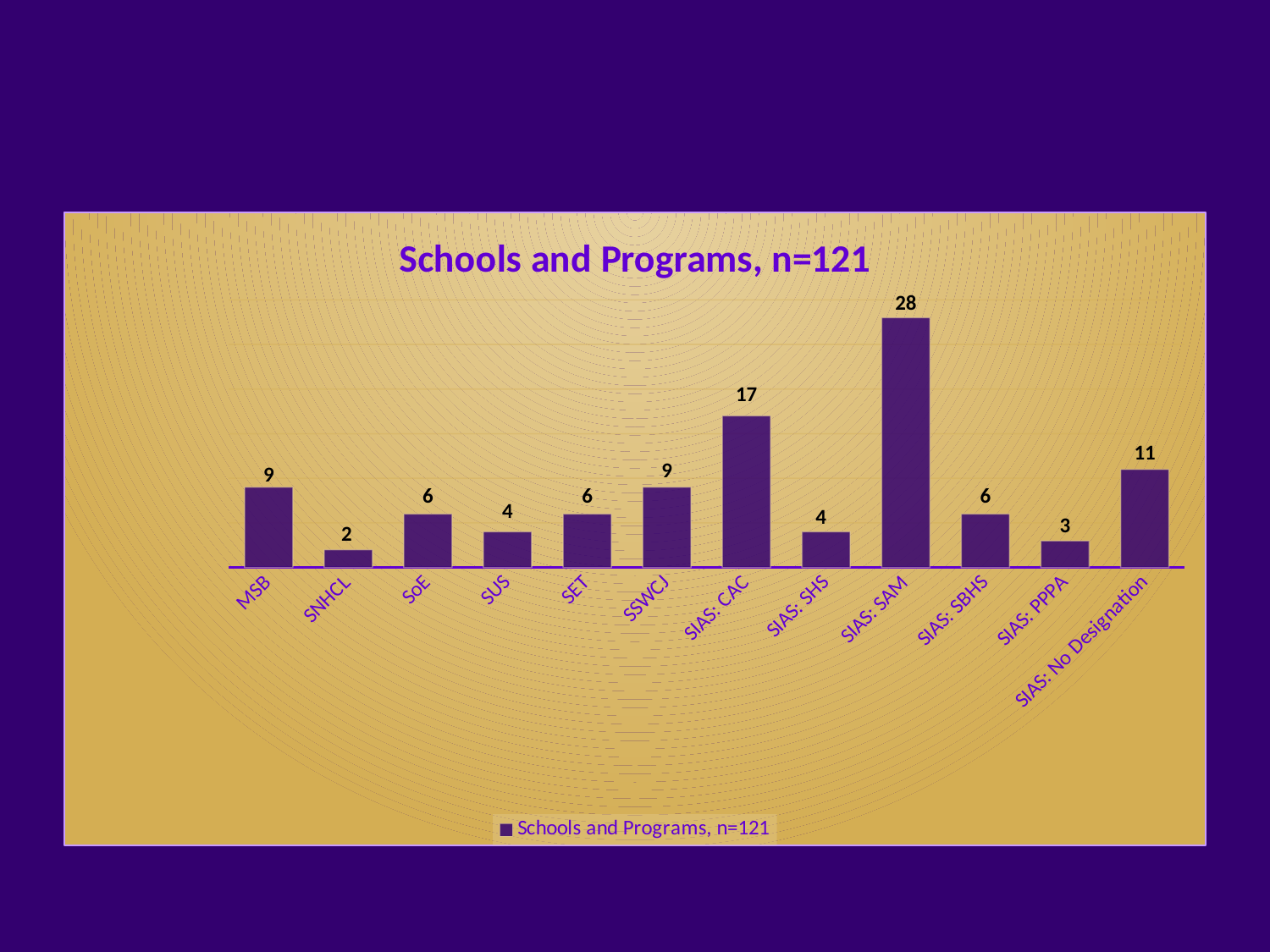
Which category has the lowest value? SNHCL What is the value for SNHCL? 2 What kind of chart is shown? Bar chart What is the title of the chart? Schools and Programs, n=121 What is the value for SIAS: No Designation? 11 What is the value for SIAS: CAC? 17 Which category has the highest value? SIAS: SAM What is the value for SIAS: SAM? 28 What is the difference between the values for SIAS: SAM and SIAS: CAC? 11 How many series does the legend list? 1 Which is larger, the value for MSB or the value for SIAS: PPPA? MSB How many categories are shown on the x axis? 12